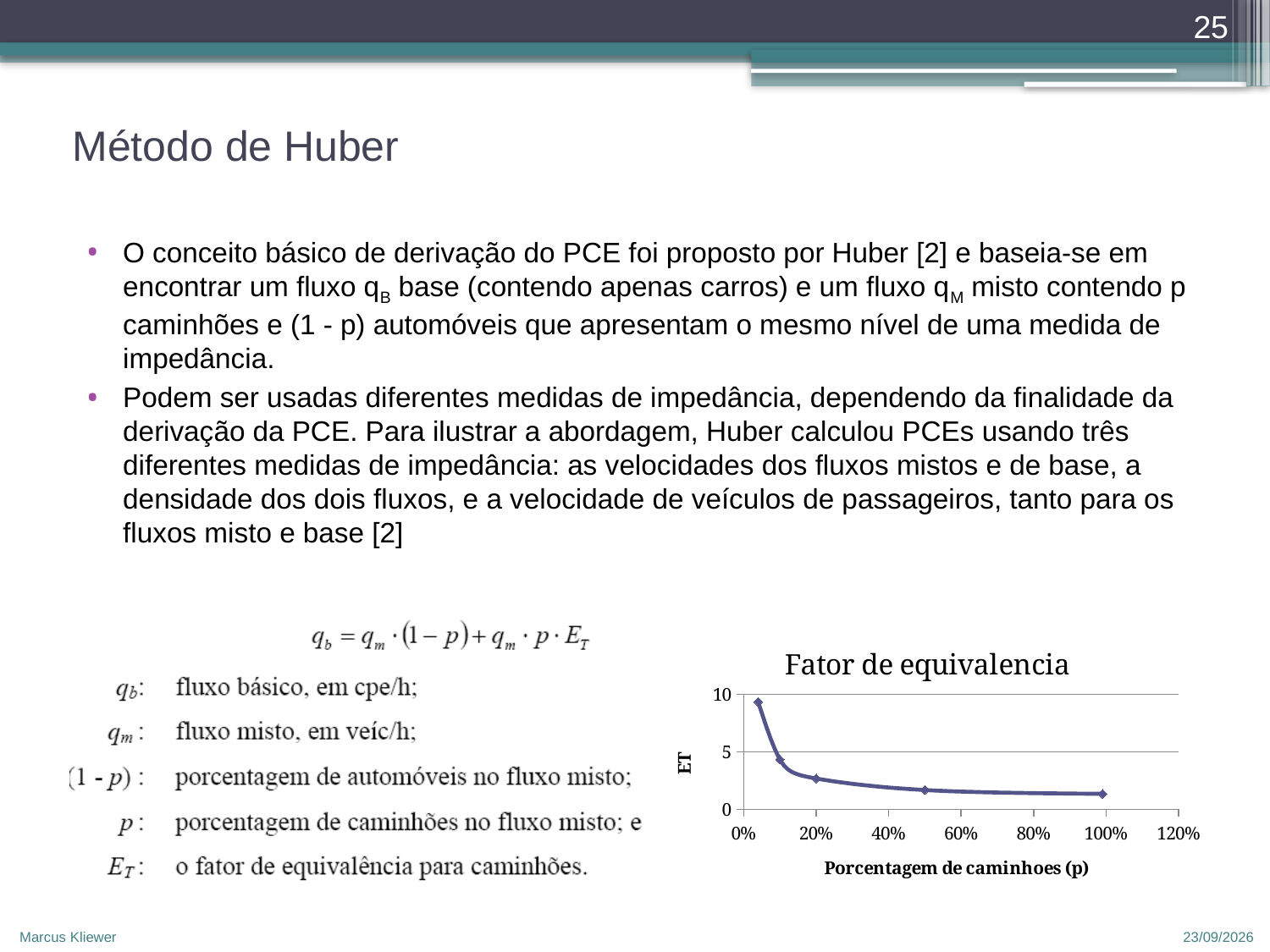
What is the highest tick value shown on the y axis (ET) of the chart? 10 What is the title of the chart on the slide? Fator de equivalencia Is the value of ET at p = 50% greater or less than 5? less What is the label of the x axis of the chart? Porcentagem de caminhoes (p) Is the value of ET at the first plotted point (near 0%) greater or less than 5? greater Is the value of ET at p = 100% greater or less than 5? less Does the value of ET rise or fall as the percentage of trucks (p) increases along the x axis? fall How many data points are plotted on the line in the chart? 5 Which plotted point has the highest ET value, the one nearest 0% or the one at 100%? the one nearest 0% What kind of chart is shown on the slide? line chart